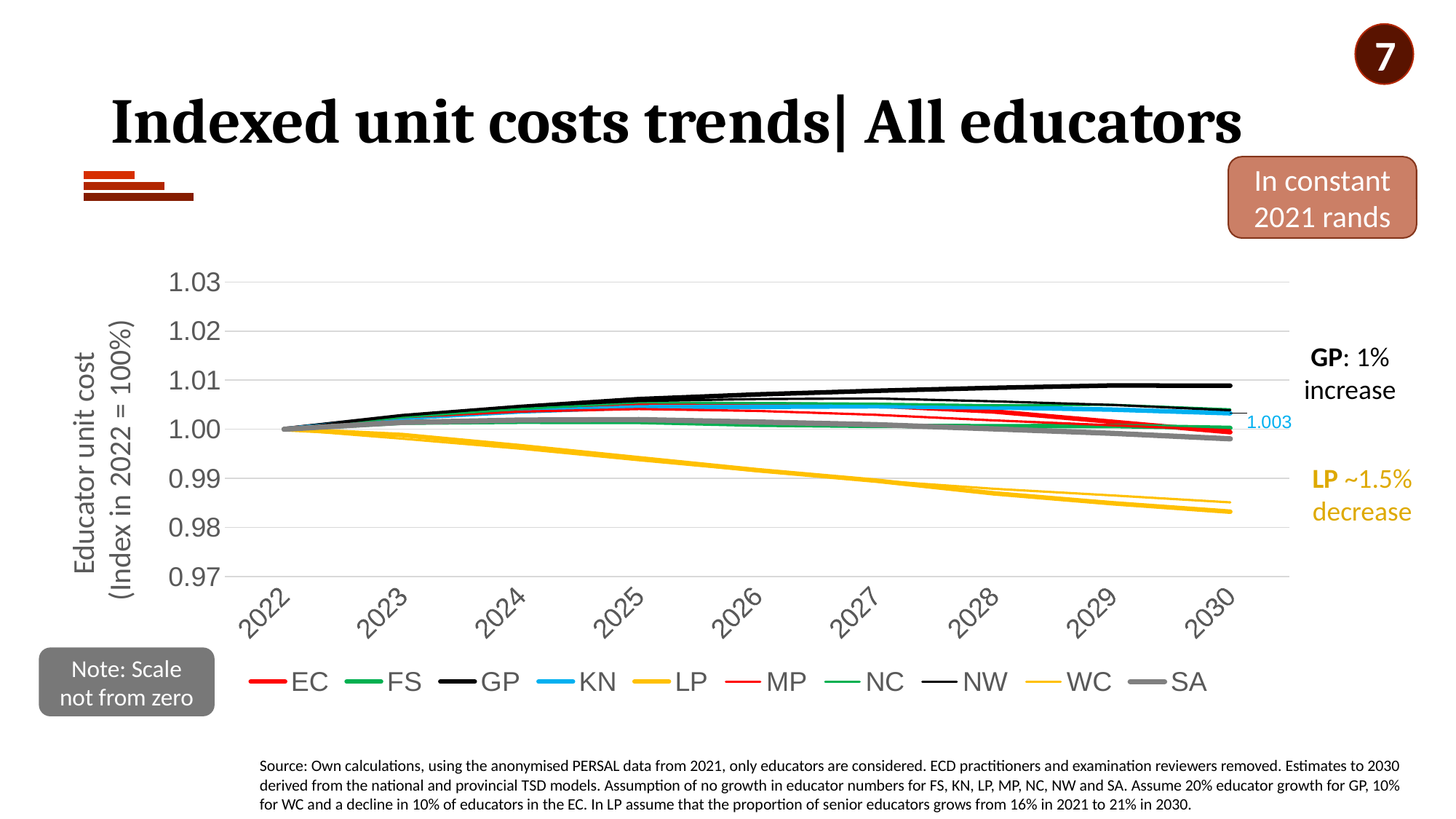
What is the value for KN in 2030? 1.003 How many years are shown along the x axis? 9 Which series has the highest value in 2030? GP What kind of chart is shown on the slide? line chart What is the value for all series in 2022? 1.00 Which is larger in 2030, the value for GP or the value for LP? GP How many series does the legend list? 10 Is the value for LP in 2030 greater or less than 0.99? less Which series has the lowest value in 2030? LP Does the LP line rise or fall from 2022 to 2030? falls Is the value for GP in 2030 greater or less than 1.00? greater What is the title of the y axis? Educator unit cost (Index in 2022 = 100%)